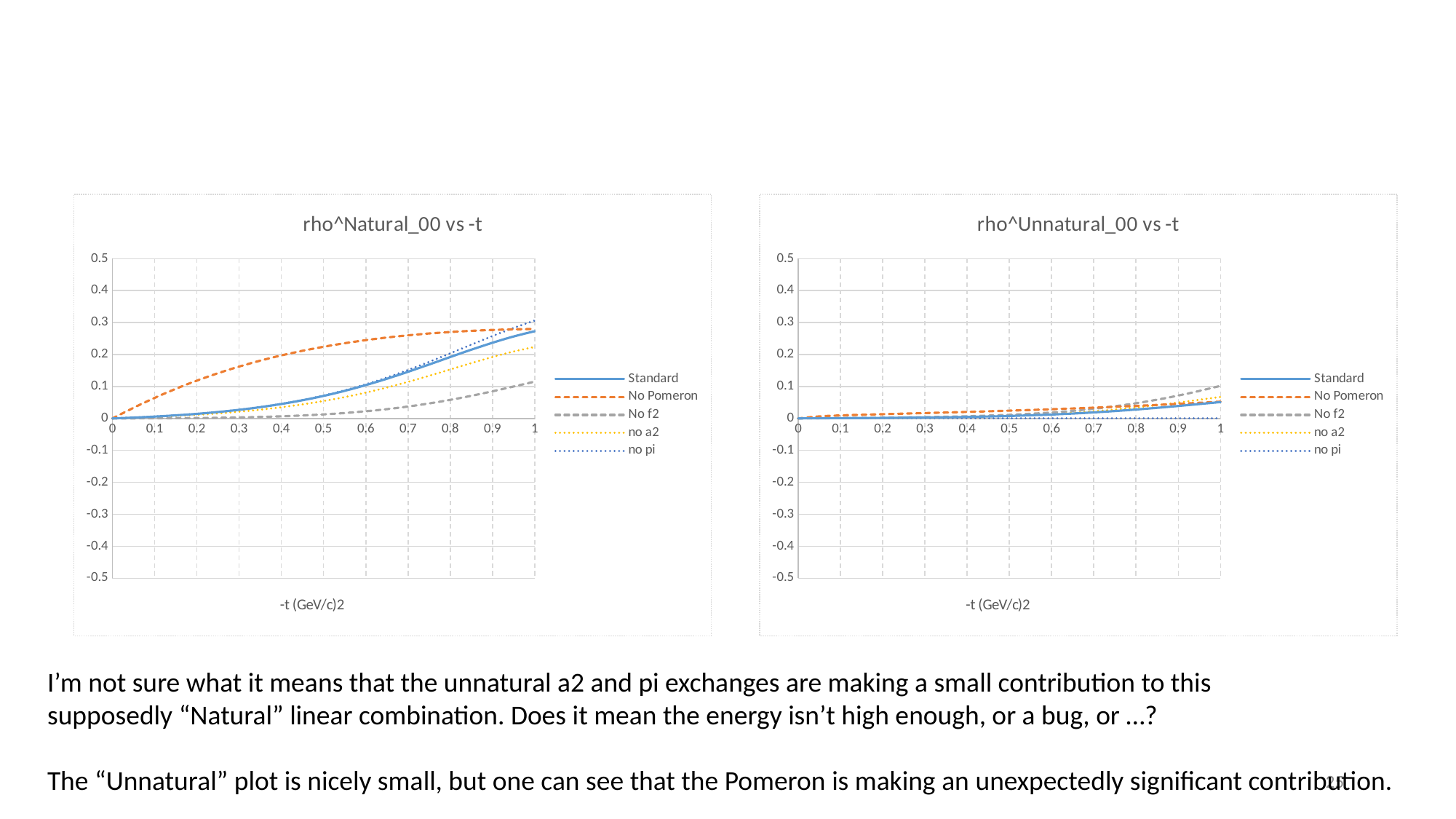
In the left chart (rho^Natural_00 vs -t), which series has the highest value at -t = 0.5? No Pomeron In the right chart (rho^Unnatural_00 vs -t), is the value of the Standard series at -t = 1 greater or less than 0.1? less In the right chart (rho^Unnatural_00 vs -t), does the No f2 series rise or fall as -t increases from 0 to 1? rise In the left chart (rho^Natural_00 vs -t), at -t = 0.3, which is larger: No Pomeron or No f2? No Pomeron What is the x-axis label of the left chart (rho^Natural_00 vs -t)? -t (GeV/c)2 What kind of chart is the left chart titled rho^Natural_00 vs -t? line chart In the left chart (rho^Natural_00 vs -t), is the value of the No f2 series at -t = 1 greater or less than 0.2? less In the left chart (rho^Natural_00 vs -t), is the value of the No Pomeron series at -t = 0.7 greater or less than 0.2? greater What is the title of the right chart? rho^Unnatural_00 vs -t In the left chart (rho^Natural_00 vs -t), which series has the lowest value at -t = 1? No f2 How many series does the legend of the left chart (rho^Natural_00 vs -t) list? 5